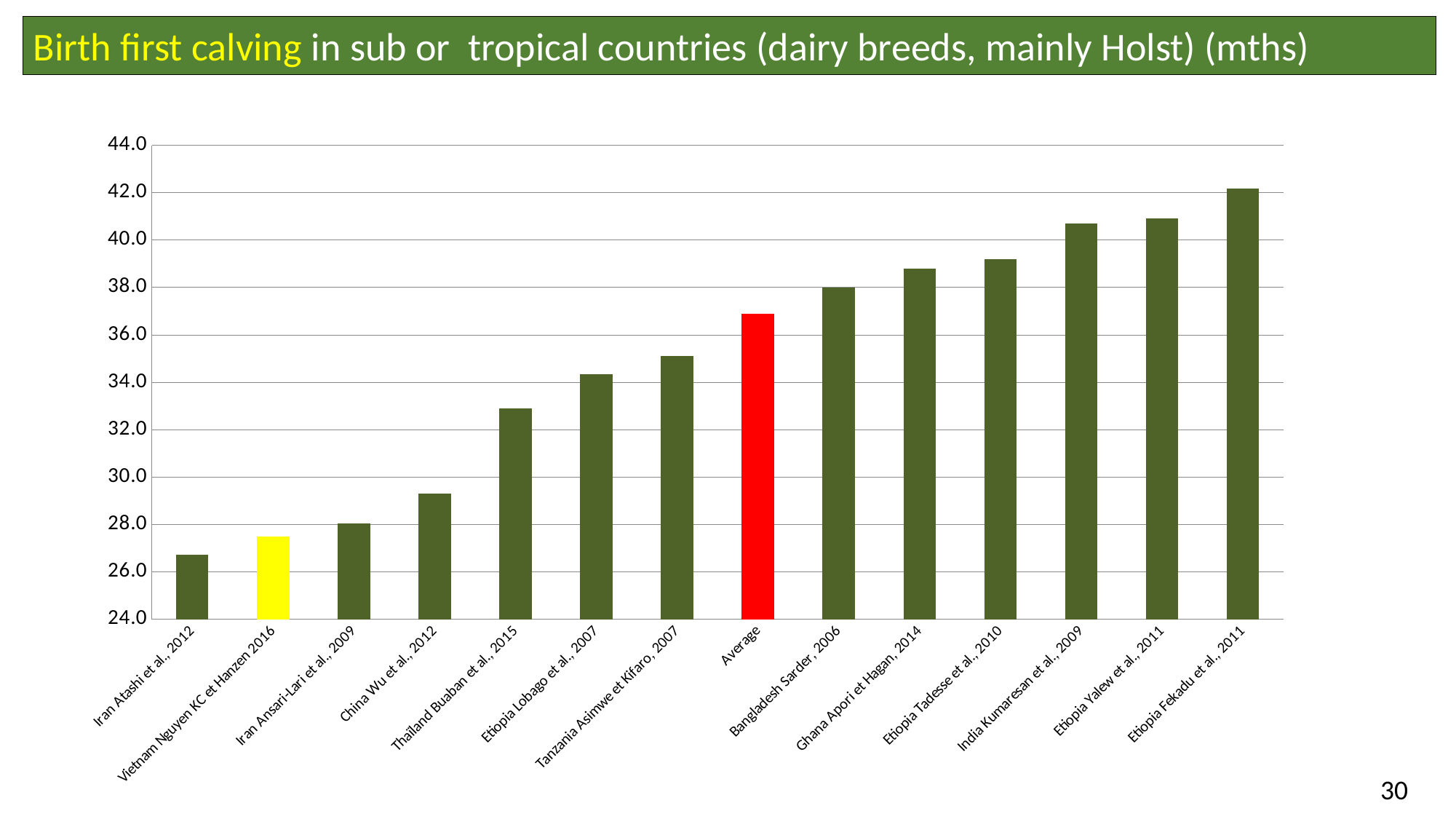
Which category has the highest value? Etiopia Fekadu et al., 2011 How many bars are plotted in the chart? 14 Is the value for Average greater or less than 38.0? less Which category has the lowest value? Iran Atashi et al., 2012 Is the value for Vietnam Nguyen KC et Hanzen 2016 greater or less than 28.0? less Which is larger, the value for Ghana Apori et Hagan, 2014 or the value for Tanzania Asimwe et Kifaro, 2007? Ghana Apori et Hagan, 2014 Do the bar values rise or fall from left to right along the x axis? rise Is the value for Thailand Buaban et al., 2015 greater or less than 32.0? greater What colour is the bar for Average? red What kind of chart is shown on the slide? bar chart Which is larger, the value for China Wu et al., 2012 or the value for Etiopia Lobago et al., 2007? Etiopia Lobago et al., 2007